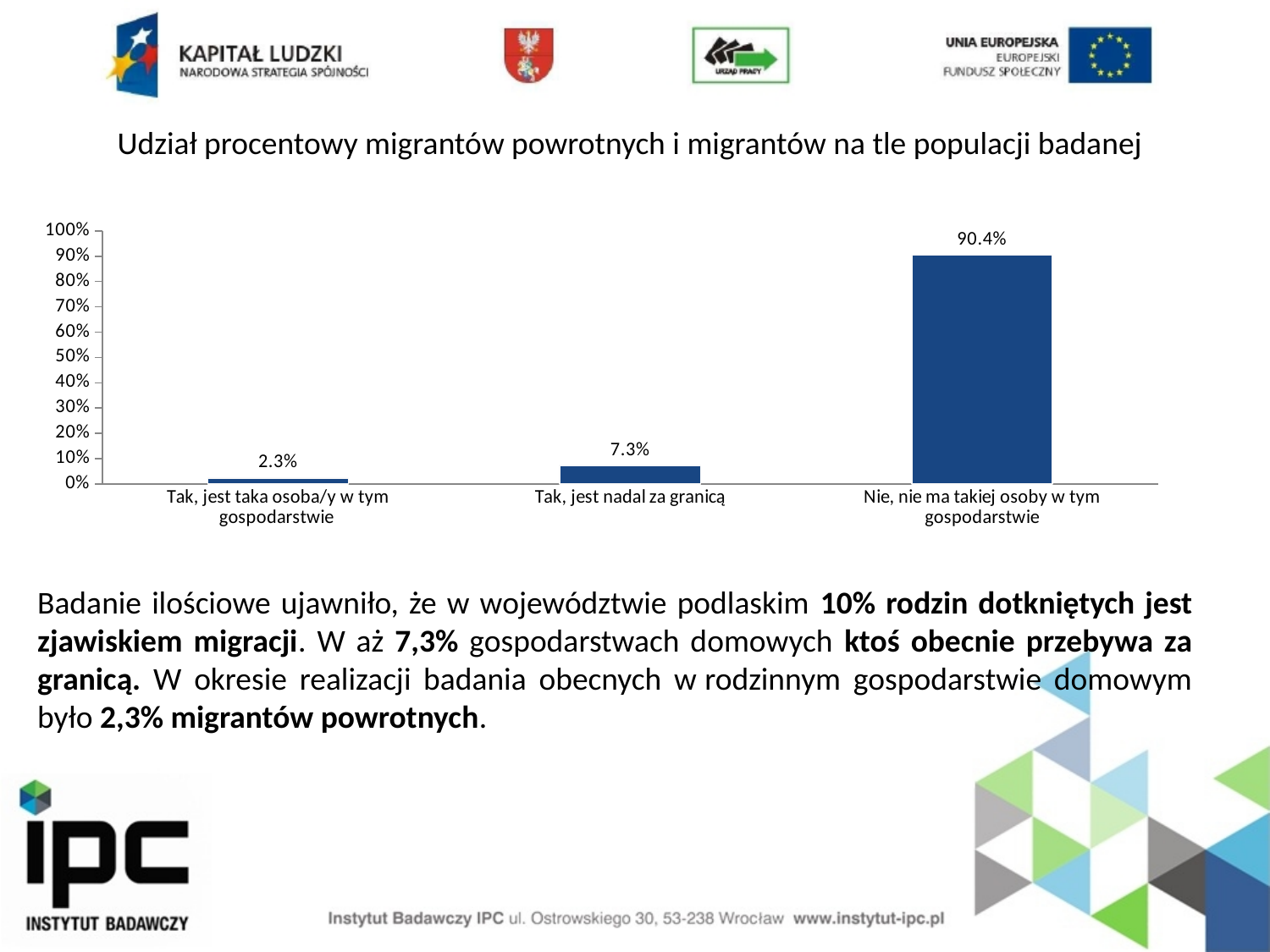
Which category has the lowest value? Tak, jest taka osoba/y w tym gospodarstwie What kind of chart is shown on the slide? bar chart What is the value for "Tak, jest taka osoba/y w tym gospodarstwie"? 2.3% Which is larger: the value for "Tak, jest nadal za granicą" or for "Tak, jest taka osoba/y w tym gospodarstwie"? Tak, jest nadal za granicą What is the value for "Tak, jest nadal za granicą"? 7.3% Is the value for "Nie, nie ma takiej osoby w tym gospodarstwie" greater or less than 80%? greater What is the difference between the values for "Tak, jest nadal za granicą" and "Tak, jest taka osoba/y w tym gospodarstwie"? 5.0% How many categories are shown on the chart? 3 What is the value for "Nie, nie ma takiej osoby w tym gospodarstwie"? 90.4% What is the difference between the values for "Nie, nie ma takiej osoby w tym gospodarstwie" and "Tak, jest nadal za granicą"? 83.1% What is the title of the chart? Udział procentowy migrantów powrotnych i migrantów na tle populacji badanej Which category has the highest value? Nie, nie ma takiej osoby w tym gospodarstwie